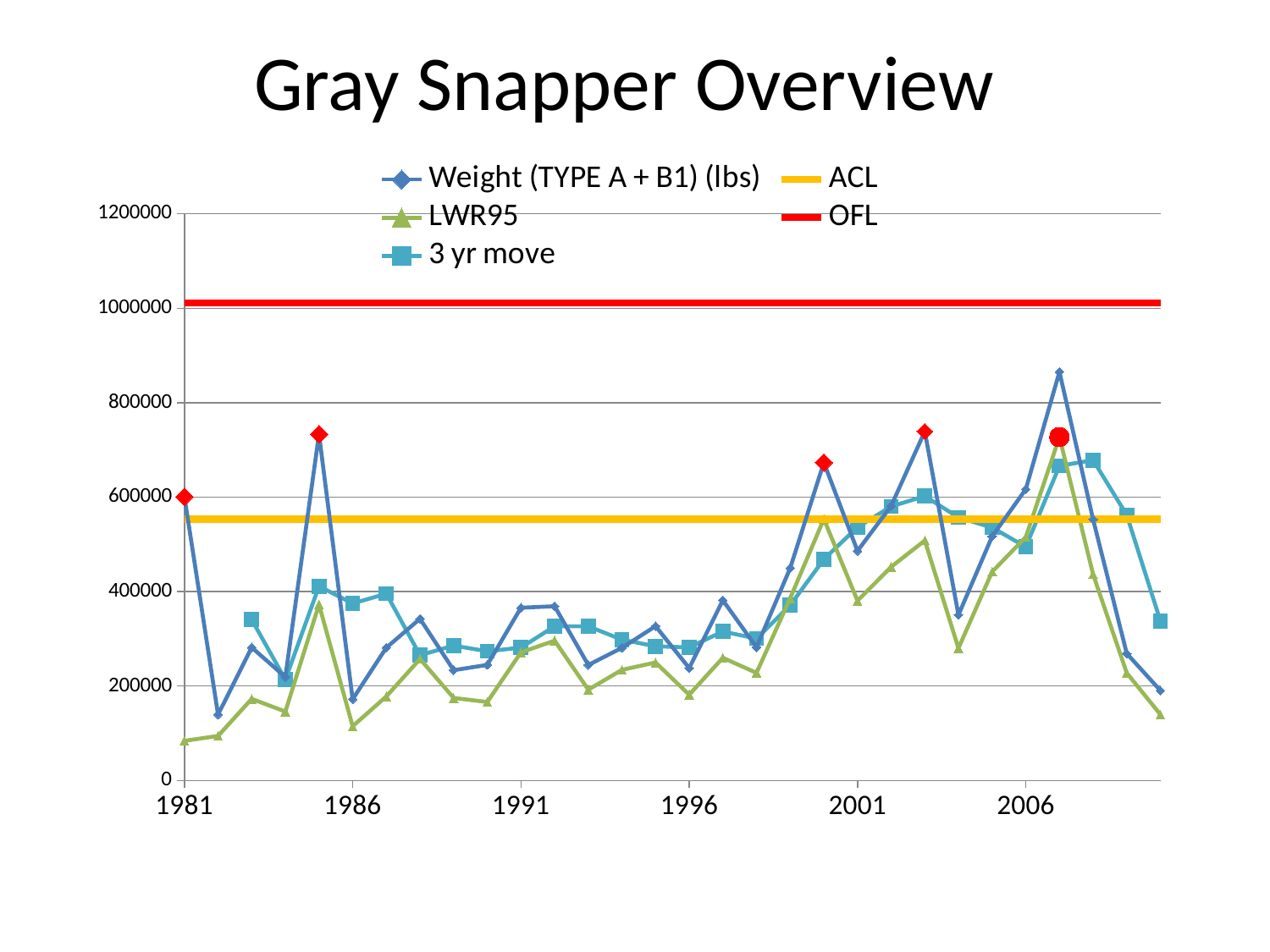
How many series does the legend list? 5 What colour is the OFL line? red Is the ACL line greater or less than 600000? less In 1986, which is higher, the Weight (TYPE A + B1) (lbs) value or the LWR95 value? Weight (TYPE A + B1) (lbs) Is the LWR95 value for 1981 greater or less than 200000? less What is the title of the chart? Gray Snapper Overview Is the Weight (TYPE A + B1) (lbs) value for 1991 greater or less than 400000? less What kind of chart is shown on the slide? line chart Does the Weight (TYPE A + B1) (lbs) series rise or fall between 1986 and 1991? rise Which is higher, the OFL line or the ACL line? OFL